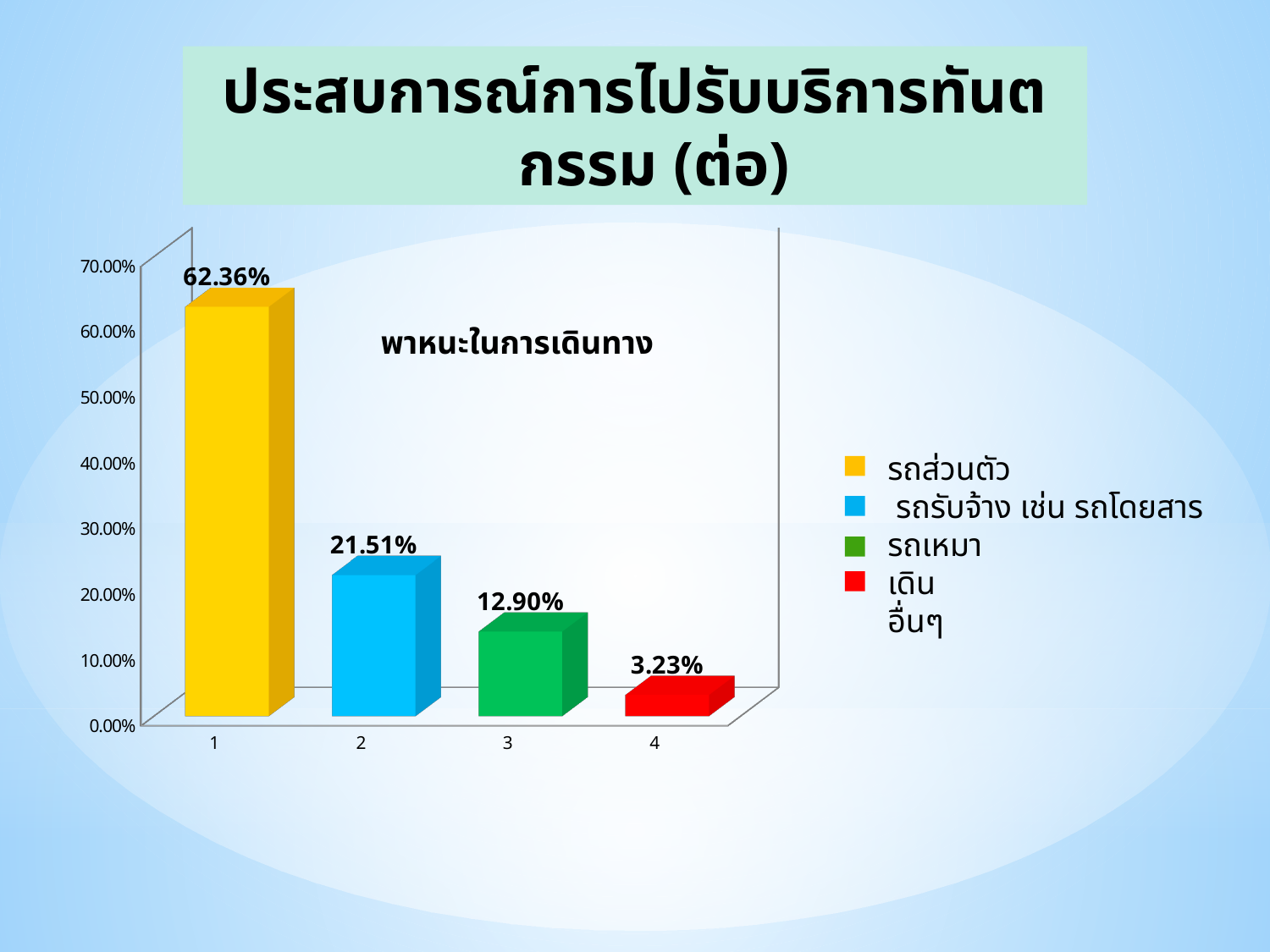
How many bars are plotted in the chart? 4 Which category has the highest value? 1 What is the value shown for category 2? 21.51% Do the values rise or fall from category 1 to category 4? fall What kind of chart is shown on the slide? bar chart What is the value shown for category 3? 12.90% What is the value shown for category 1? 62.36% Which category has the lowest value? 4 Which is larger, the value for category 3 or category 4? category 3 What is the value shown for category 4? 3.23% What is the difference between the values for category 2 and category 3? 8.61% What is the difference between the values for category 1 and category 2? 40.85%